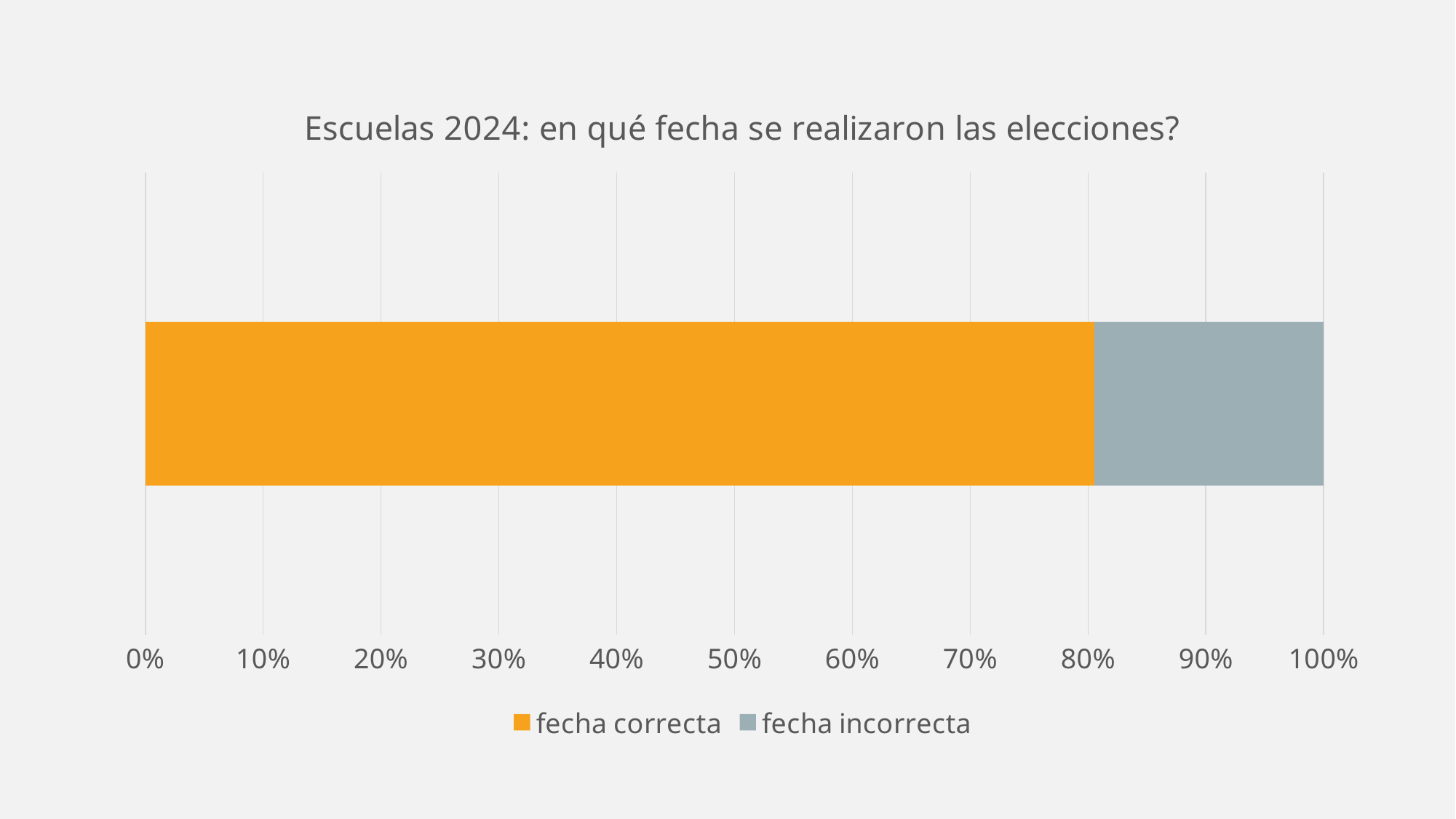
Which series has the largest share of the bar? fecha correcta Which colour represents 'fecha correcta' in the chart? orange What kind of chart is shown on the slide? bar chart Is the value for 'fecha correcta' greater or less than 90%? less How many bars are plotted in the chart? 1 Which series has the smallest share of the bar? fecha incorrecta Is the value for 'fecha incorrecta' greater or less than 30%? less What is the total of the stacked bar according to the axis? 100% How many series does the legend list? 2 What is the title of the chart? Escuelas 2024: en qué fecha se realizaron las elecciones? Which series takes up the larger share of the bar, 'fecha correcta' or 'fecha incorrecta'? fecha correcta Is the value for 'fecha correcta' greater or less than 70%? greater